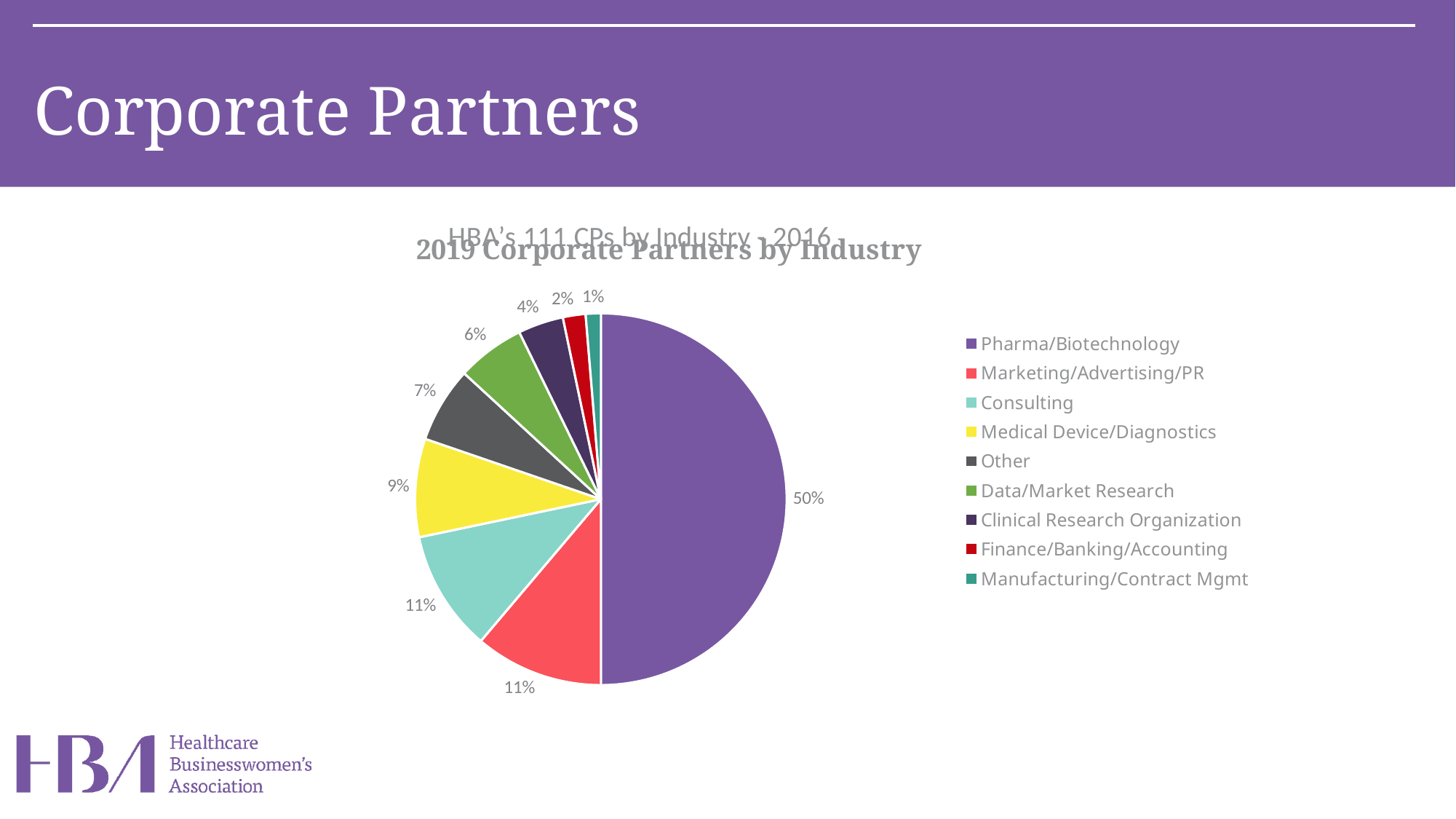
Which industry has the largest slice of the pie? Pharma/Biotechnology What is the difference in percentage points between Other and Finance/Banking/Accounting? 5 What percentage is shown for Data/Market Research? 6% What kind of chart is shown on the slide? Pie chart What colour is the slice for Finance/Banking/Accounting? Dark red Which industry has the smallest slice of the pie? Manufacturing/Contract Mgmt How many industry categories does the legend list? 9 What share of the pie does Pharma/Biotechnology hold? 50% What is the difference in percentage points between Pharma/Biotechnology and Consulting? 39 What percentage is shown for Clinical Research Organization? 4% What percentage is shown for Medical Device/Diagnostics? 9% Which is larger, the share for Medical Device/Diagnostics or the share for Other? Medical Device/Diagnostics